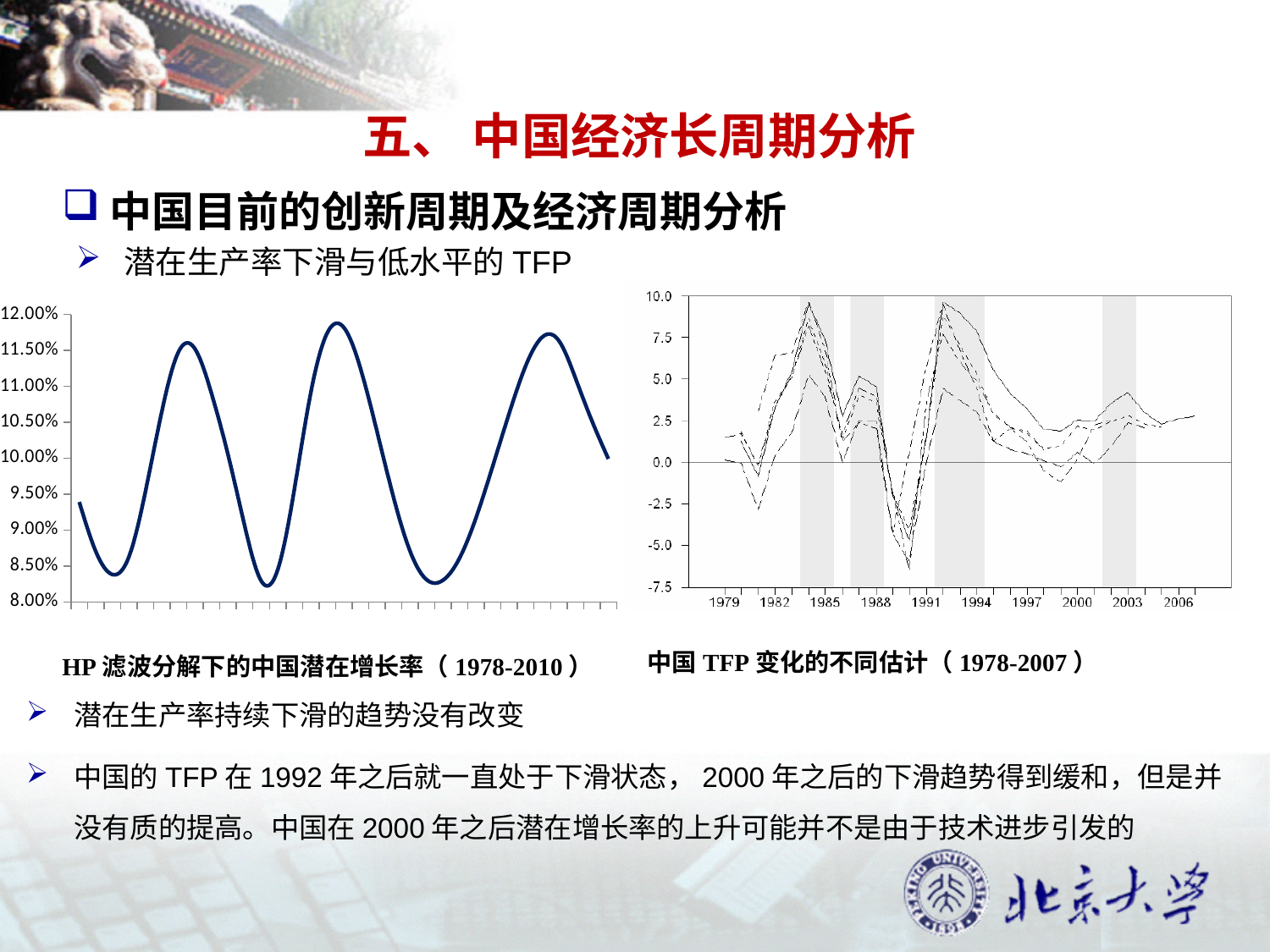
In the left chart (HP 滤波分解下的中国潜在增长率), is the value at the second (middle) peak of the line greater or less than 11.50%? greater In the left chart (HP 滤波分解下的中国潜在增长率), what is the lowest value shown on the y axis? 8.00% In the left chart (HP 滤波分解下的中国潜在增长率), what is the highest value shown on the y axis? 12.00% What kind of chart is the right chart titled '中国 TFP 变化的不同估计（1978-2007）'? line chart What kind of chart is the left chart titled 'HP 滤波分解下的中国潜在增长率（1978-2010）'? line chart In the left chart (HP 滤波分解下的中国潜在增长率), is the value at the lowest trough of the line greater or less than 9.00%? less In the left chart (HP 滤波分解下的中国潜在增长率), does the line rise or fall over its final segment at the right end of the x axis? fall In the right chart (中国 TFP 变化的不同估计), what is the first year label on the x axis? 1979 In the right chart (中国 TFP 变化的不同估计), are the values of the lines around 1990 greater or less than 0.0? less In the right chart (中国 TFP 变化的不同估计), how many year labels are shown on the x axis? 10 In the right chart (中国 TFP 变化的不同估计), do the lines rise or fall between 1992 and 1997? fall